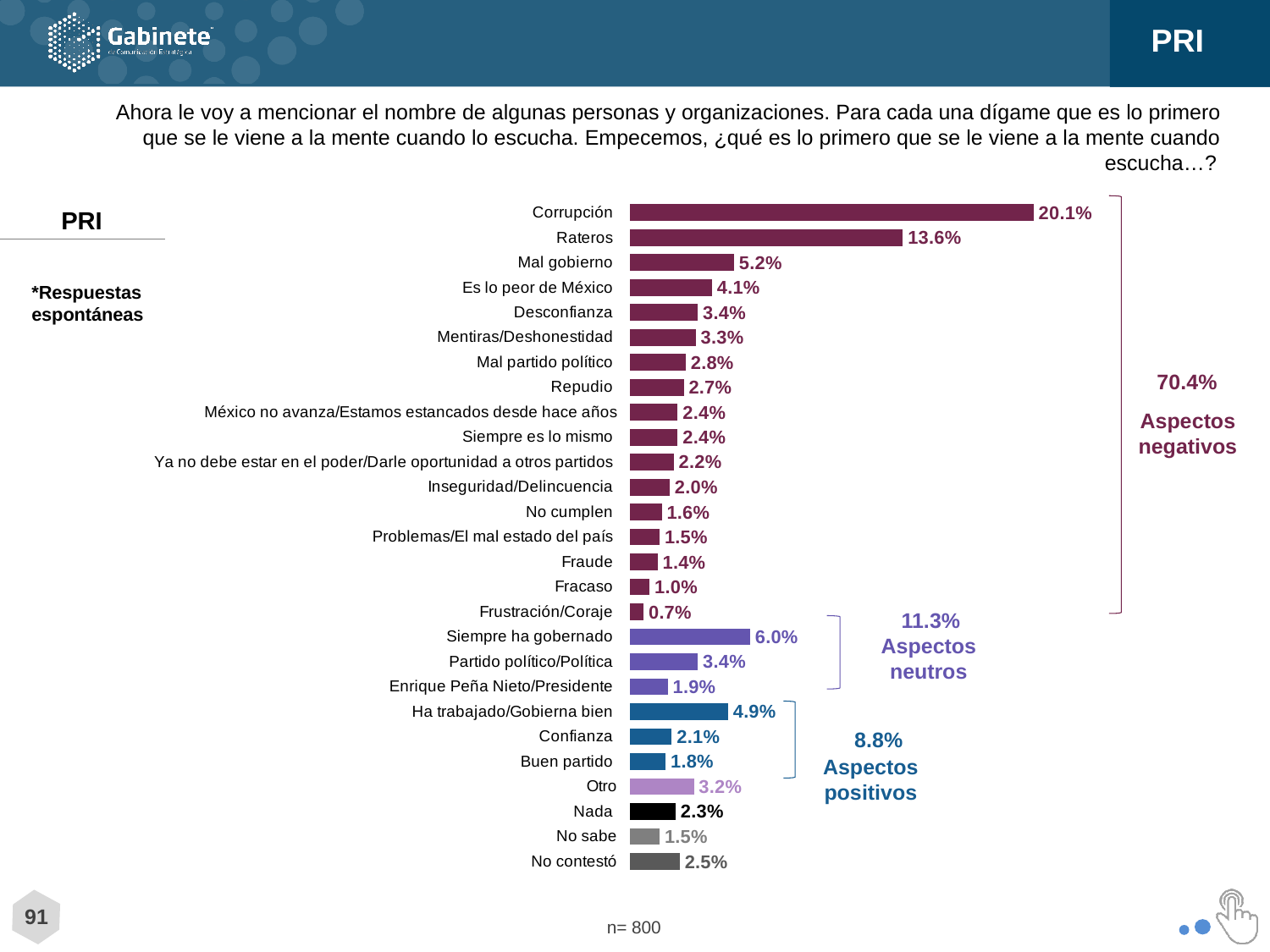
What percentage is labelled as Aspectos negativos? 70.4% What is the difference between the values for Corrupción and Rateros? 6.5% Which is larger, the value for Mal gobierno or the value for Siempre ha gobernado? Siempre ha gobernado What is the value for Rateros? 13.6% What is the value for Siempre ha gobernado? 6.0% What is the value for Corrupción? 20.1% Which category has the lowest value? Frustración/Coraje What is the value for Ha trabajado/Gobierna bien? 4.9% How many categories are shown in the chart? 27 What is the value for No contestó? 2.5% What kind of chart is shown on the slide? Bar chart Which category has the highest value? Corrupción